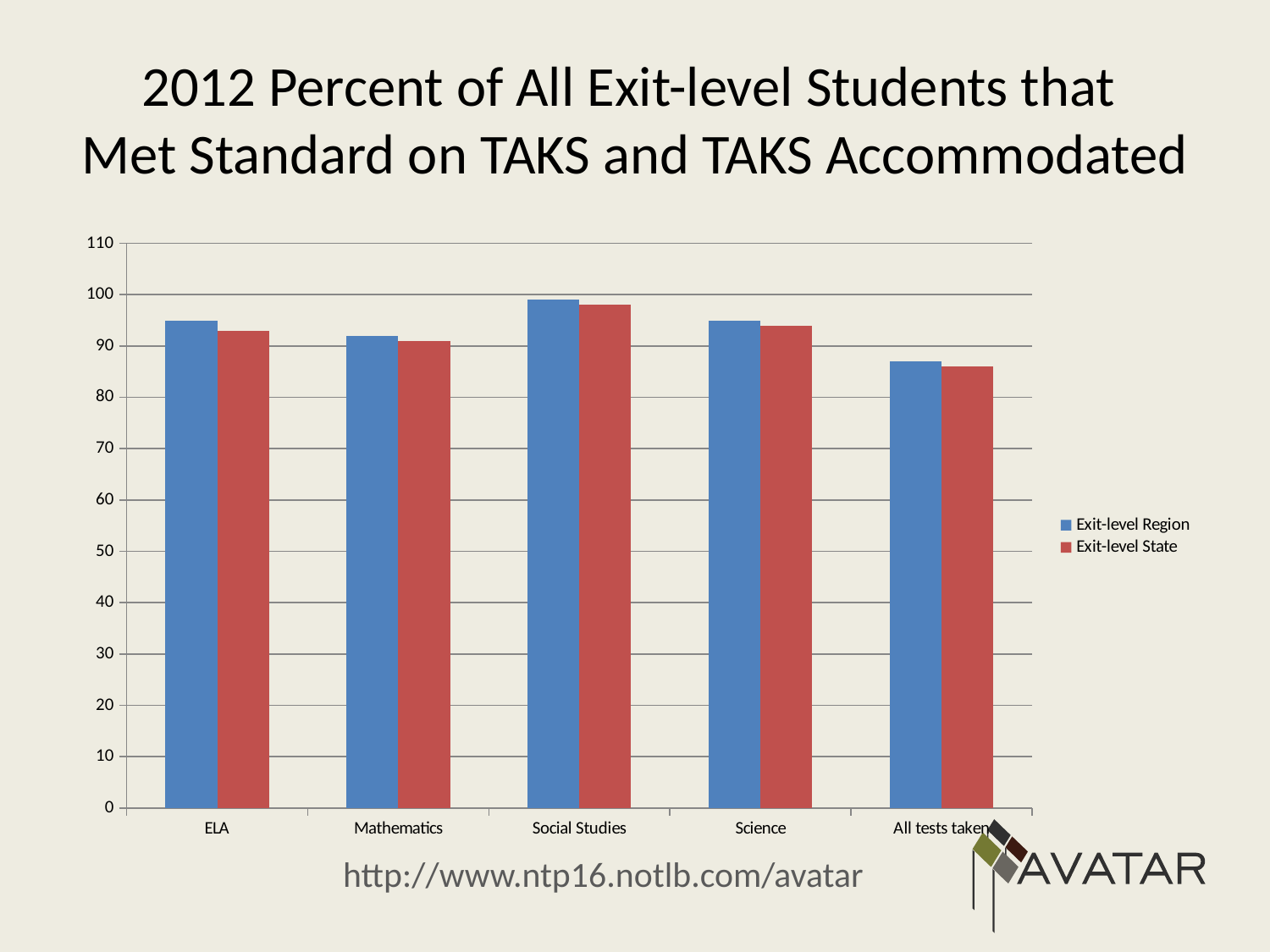
Which is larger: the Exit-level Region value for Social Studies or the Exit-level Region value for All tests taken? Social Studies Is the Exit-level State value for All tests taken greater or less than 90? less What kind of chart is shown on the slide? bar chart How many series does the legend list? 2 Which category has the lowest Exit-level Region value? All tests taken Which is larger: the Exit-level State value for Science or the Exit-level State value for All tests taken? Science What colour are the Exit-level State bars? red Which category has the lowest Exit-level State value? All tests taken Is the Exit-level State value for Mathematics greater or less than 80? greater Which category has the highest Exit-level Region value? Social Studies Is the Exit-level Region value for Social Studies greater or less than 90? greater How many categories are shown on the x axis? 5